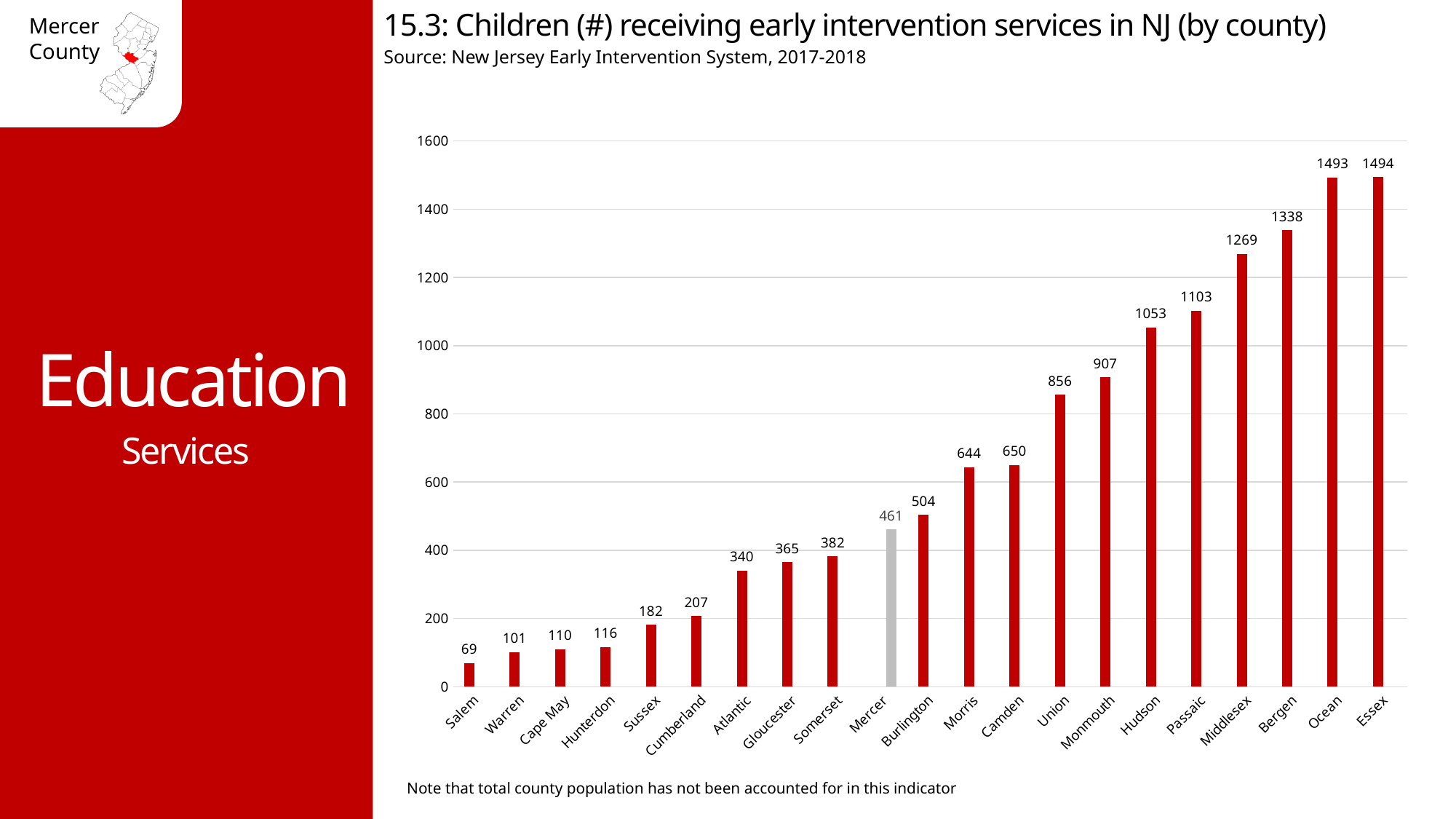
What is the difference between the values for Burlington and Mercer? 43 What kind of chart is shown on the slide? Bar chart How many counties are shown on the chart? 21 Which county's bar is shown in grey rather than red? Mercer Which county has a larger value, Atlantic or Somerset? Somerset Which county has a larger value, Union or Monmouth? Monmouth What is the value shown for Hudson County? 1053 How many children in Mercer County are receiving early intervention services? 461 Which county has the lowest number of children receiving early intervention services? Salem Is the value for Passaic greater or less than 1000? greater What is the difference between the values for Bergen and Middlesex? 69 What is the value shown for Cumberland County? 207